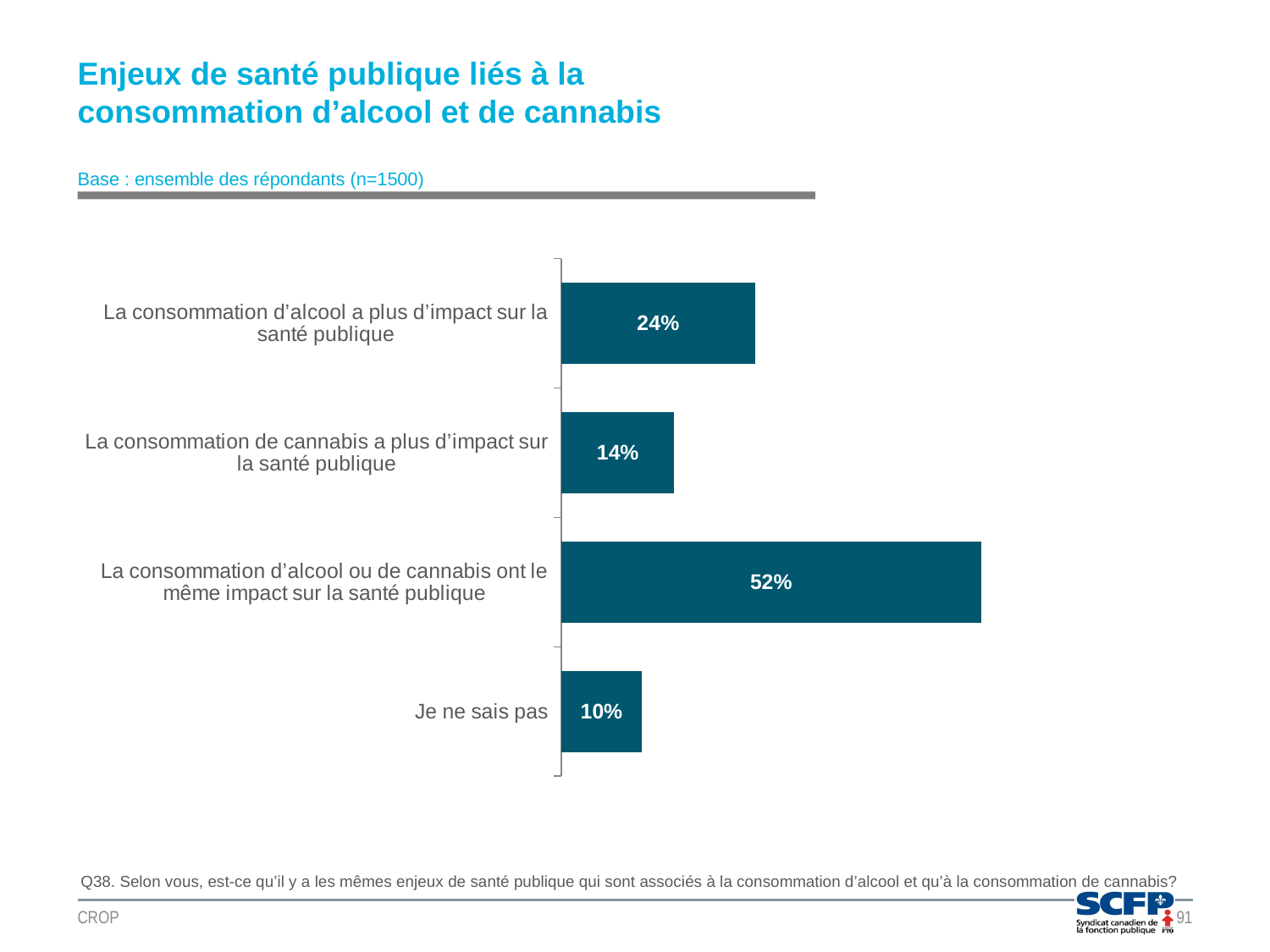
What is the difference between the value for alcohol having more impact and the value for cannabis having more impact? 10% How many categories are shown in the chart? 4 What is the value for "La consommation de cannabis a plus d’impact sur la santé publique"? 14% What kind of chart is shown on the slide? Bar chart Which category has the lowest value? Je ne sais pas What is the base (number of respondents) stated for the chart? n=1500 Which category has the highest value? La consommation d’alcool ou de cannabis ont le même impact sur la santé publique Which is larger: the value for "La consommation de cannabis a plus d’impact sur la santé publique" or the value for "Je ne sais pas"? La consommation de cannabis a plus d’impact sur la santé publique What is the difference between the value for "La consommation d’alcool ou de cannabis ont le même impact sur la santé publique" and the value for "La consommation d’alcool a plus d’impact sur la santé publique"? 28% What percentage of respondents said alcohol consumption has more impact on public health ("La consommation d’alcool a plus d’impact sur la santé publique")? 24% What is the value for "Je ne sais pas"? 10% What is the title of the slide? Enjeux de santé publique liés à la consommation d’alcool et de cannabis